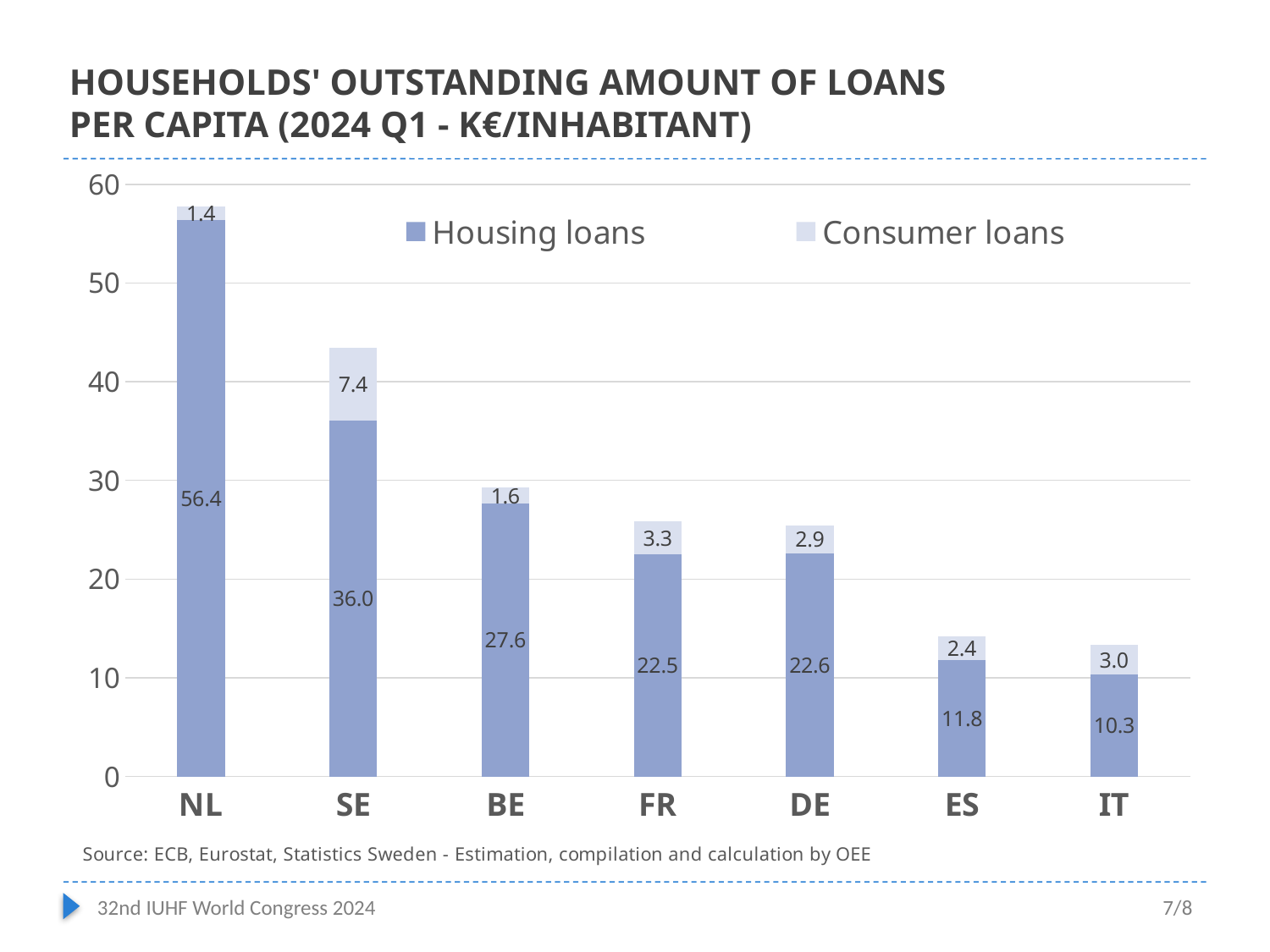
What is the value of Consumer loans for SE? 7.4 How many countries are shown on the x axis? 7 Which country has the highest Housing loans value? NL What is the value of Housing loans for IT? 10.3 How many series does the legend list? 2 What is the total of the stacked bar for ES? 14.2 Which series is shown in the darker blue colour? Housing loans Which country has the lowest Consumer loans value? NL What is the value of Housing loans for NL? 56.4 What is the difference between the Housing loans values for SE and BE? 8.4 Which is larger, the Consumer loans value for FR or for DE? FR What kind of chart is shown on the slide? Stacked bar chart